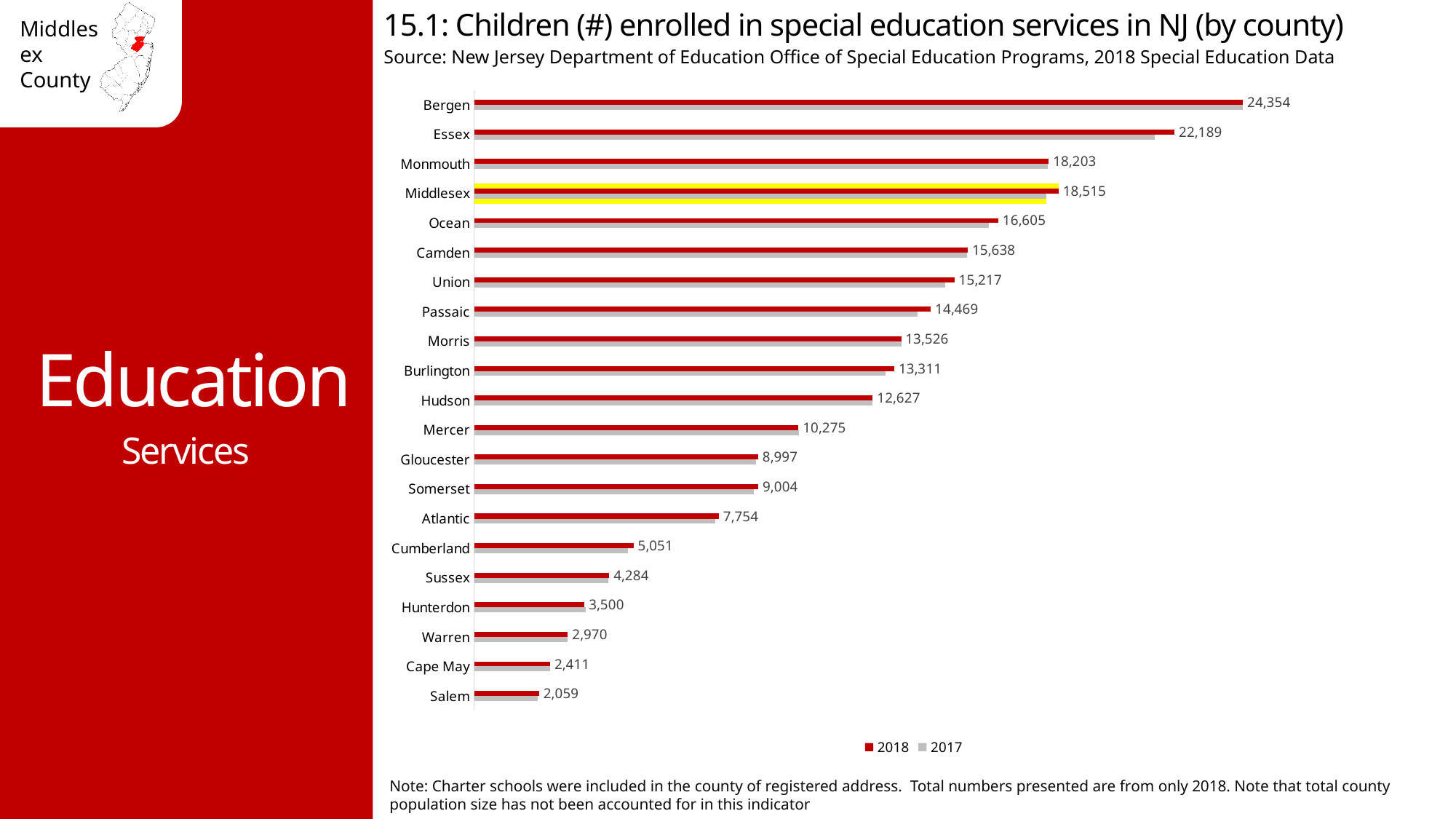
What is the difference between the 2018 values for Middlesex and Monmouth? 312 What is the 2018 value shown for Bergen County? 24,354 How many counties are listed in the chart? 21 Which county has the larger 2018 value, Somerset or Gloucester? Somerset How many series does the legend list? 2 What is the 2018 value shown for Ocean County? 16,605 Which county has the lowest number of children enrolled in special education services in 2018? Salem How many children were enrolled in special education services in Middlesex County in 2018? 18,515 Which county's bars are highlighted in yellow on the chart? Middlesex What is the difference between the 2018 values for Bergen and Essex? 2,165 What kind of chart is shown on the slide? bar chart Which county has the highest number of children enrolled in special education services in 2018? Bergen